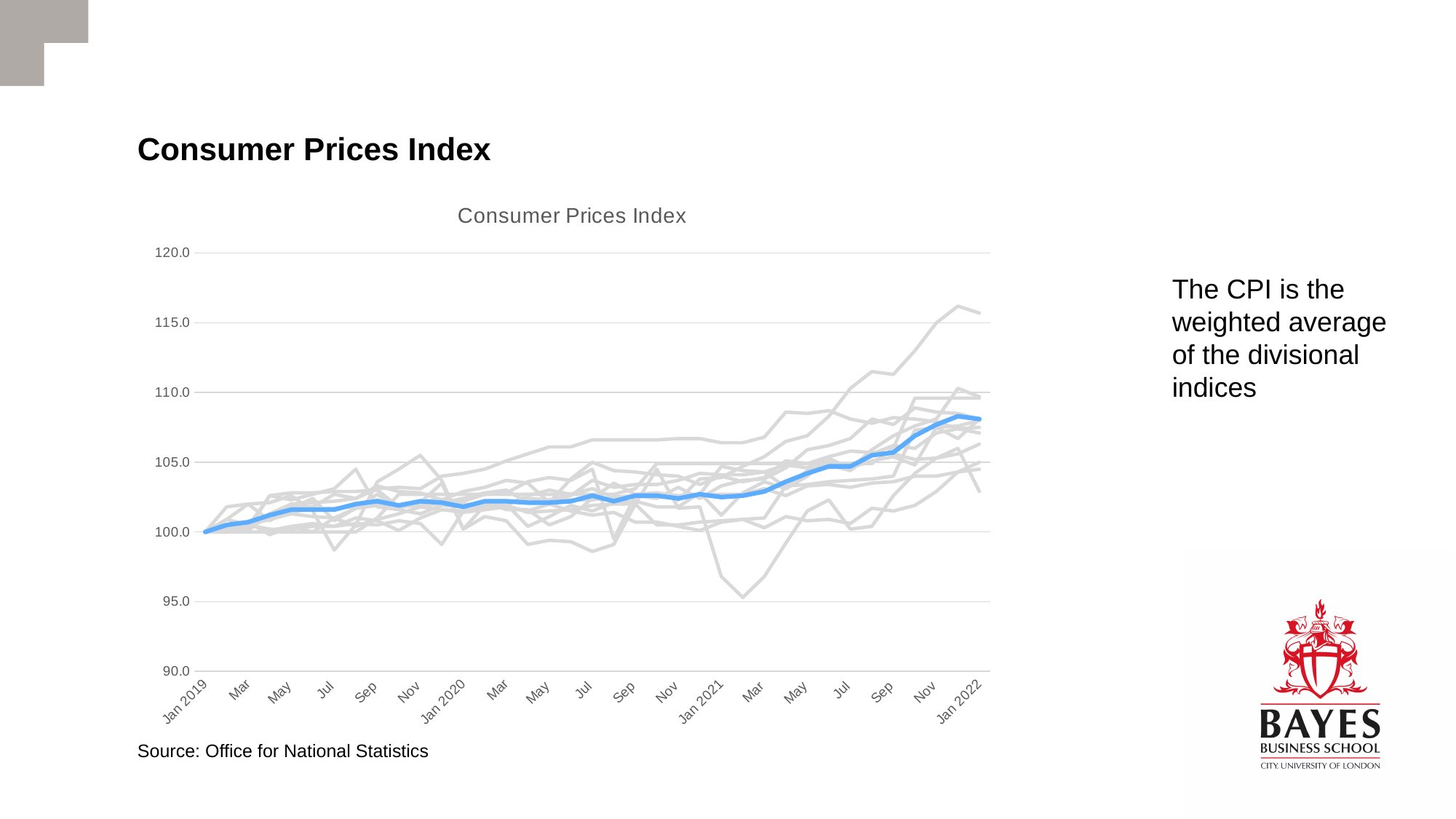
Is the value of the blue CPI line at Jan 2022 greater or less than 110.0? less Is the highest point reached by any grey divisional line greater or less than 115.0? greater What is the title of the chart? Consumer Prices Index What kind of chart is shown on the slide? Line chart What is the value of the blue CPI line at Jan 2019? 100.0 Is the value of the blue CPI line at Jan 2021 greater or less than 105.0? less How many labels are shown on the horizontal axis? 19 What is the highest value shown on the vertical axis? 120.0 Does the blue CPI line generally rise or fall from Jan 2019 to Jan 2022? Rise What colour is the highlighted line representing the overall CPI? Blue